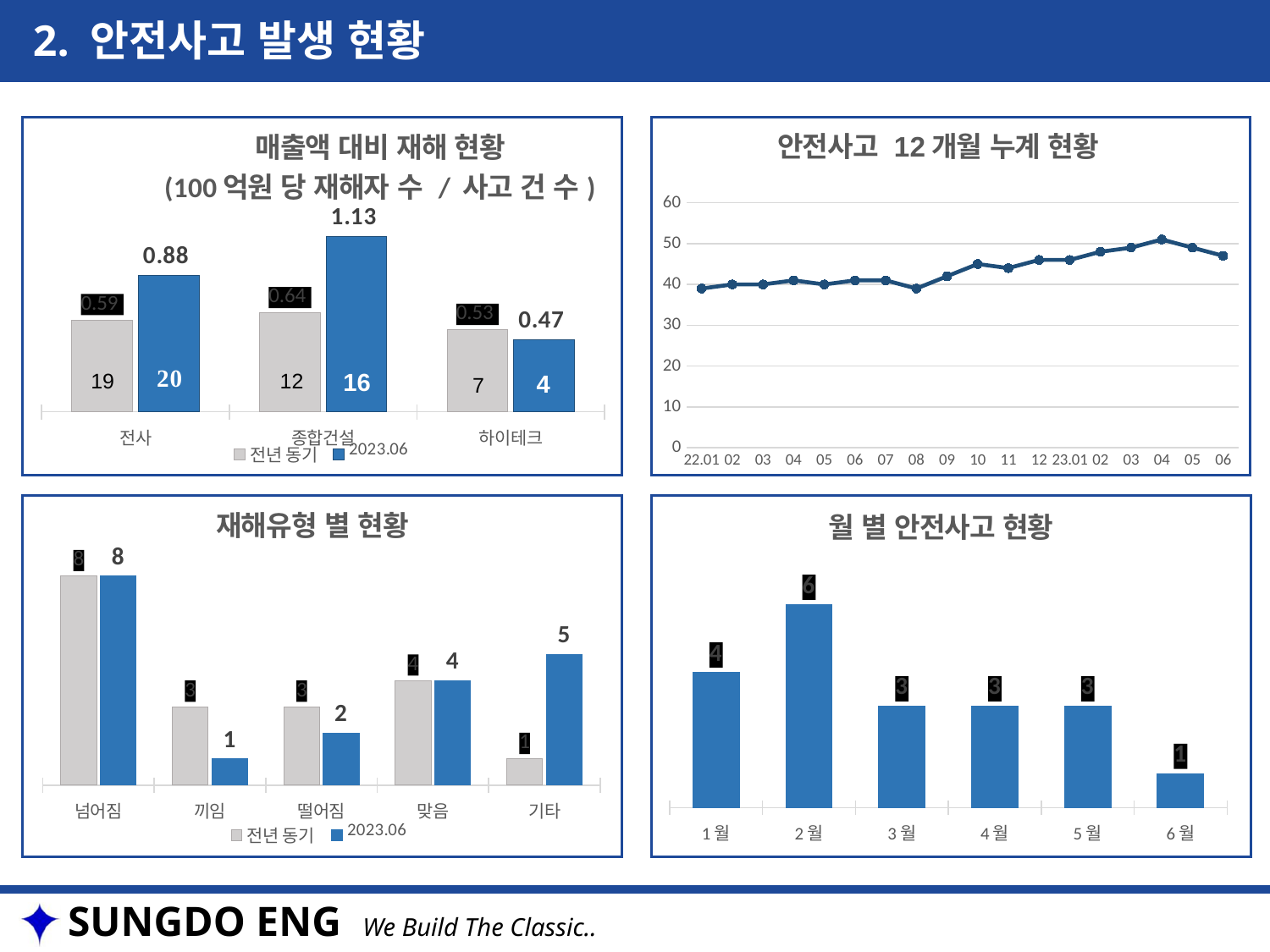
In the chart titled 매출액 대비 재해 현황, what is the 전년 동기 value for 전사? 0.59 In the chart titled 월 별 안전사고 현황, what is the value for 6 월? 1 In the chart titled 안전사고 12 개월 누계 현황, is the value at 22.08 greater or less than 40? less In the chart titled 안전사고 12 개월 누계 현황, is the value at 23.04 greater or less than 50? greater In the chart titled 재해유형 별 현황, what is the 2023.06 value for 기타? 5 In the chart titled 매출액 대비 재해 현황, how many series does the legend list? 2 In the chart titled 재해유형 별 현황, what is the difference between the 전년 동기 and 2023.06 values for 끼임? 2 What kind of chart is the chart titled 안전사고 12 개월 누계 현황? line chart In the chart titled 매출액 대비 재해 현황, what is the 2023.06 value for 종합건설? 1.13 In the chart titled 매출액 대비 재해 현황, which category has the highest 2023.06 value? 종합건설 In the chart titled 재해유형 별 현황, how many categories are shown on the x axis? 5 In the chart titled 월 별 안전사고 현황, which month has the highest value? 2 월